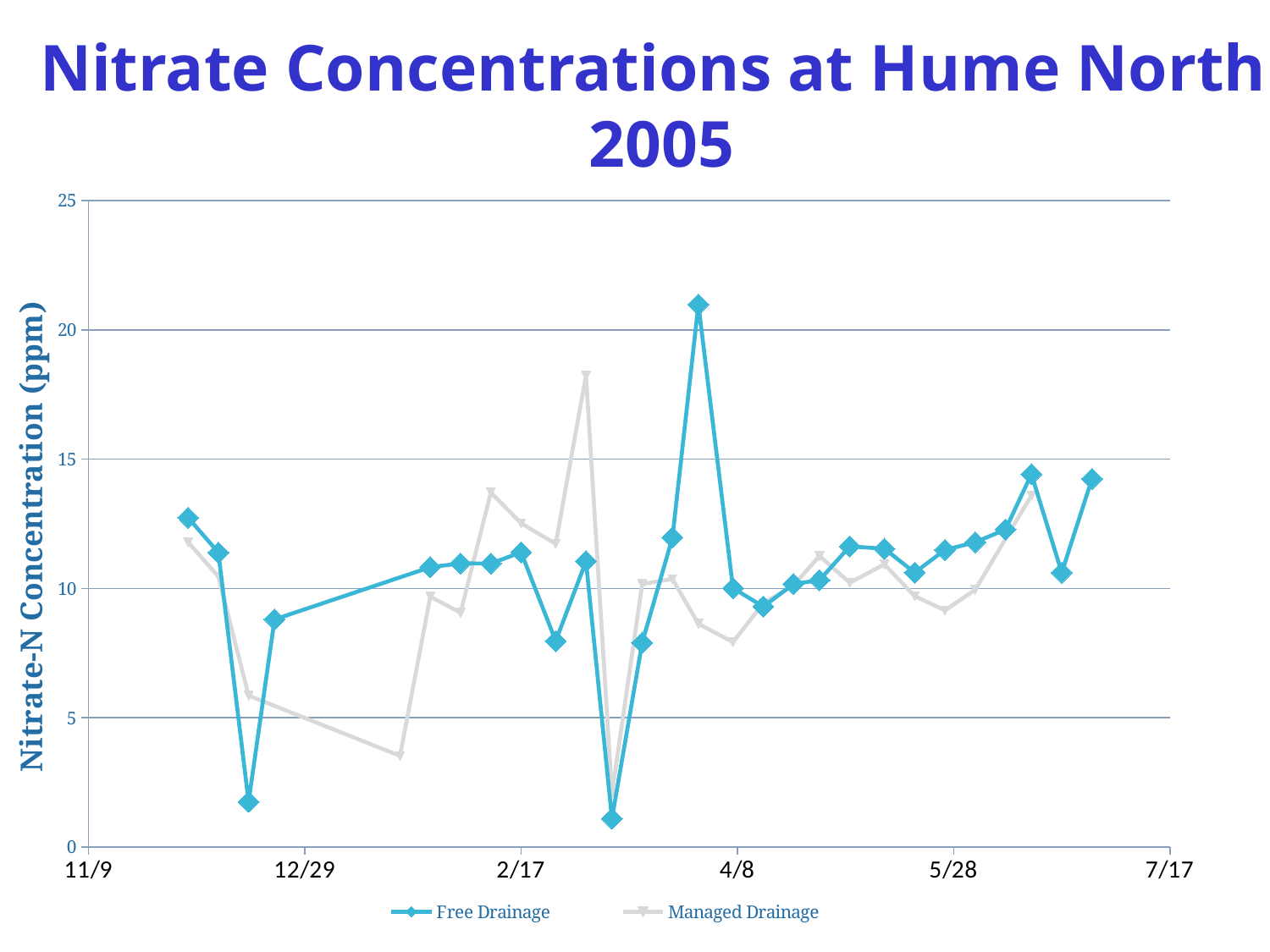
What are the two series named in the legend? Free Drainage and Managed Drainage Is the first plotted value of the Free Drainage series greater or less than 10? greater Is the highest value reached by the Managed Drainage series greater or less than 15? greater Is the highest value reached by the Free Drainage series greater or less than 20? greater What kind of chart is shown on the slide? Line chart How many series does the legend list? 2 Immediately after its peak above 20, does the Free Drainage line rise or fall? fall What is the label on the vertical axis? Nitrate-N Concentration (ppm) Which series reaches the higher peak value, Free Drainage or Managed Drainage? Free Drainage